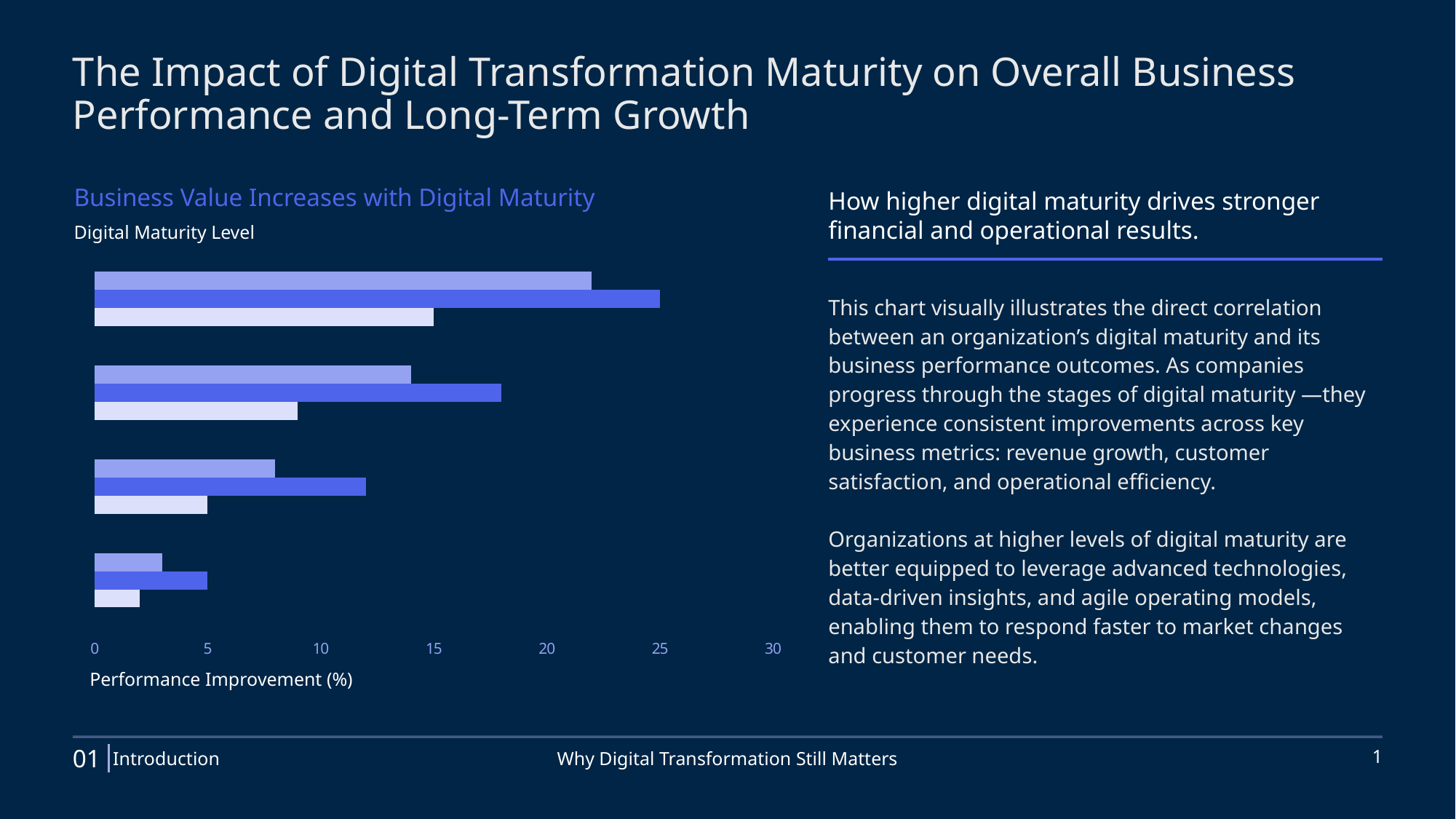
What kind of chart is shown on the slide? Bar chart What is the title of the horizontal axis of the chart? Performance Improvement (%) What is the value of the middle (dark blue) bar in the top group? 25 How many groups of bars does the chart show? 4 Moving from the top group to the bottom group, do the bar lengths increase or decrease? Decrease Is the longest bar in the top group greater or less than 20? greater Which group of bars has the longest bars overall? The top group Is the longest bar in the bottom group greater or less than 10? less How many bars are in each group of the chart? 3 What is the title of the chart? Business Value Increases with Digital Maturity What is the highest value shown on the horizontal axis of the chart? 30 What is the value of the bottom (lightest) bar in the top group? 15